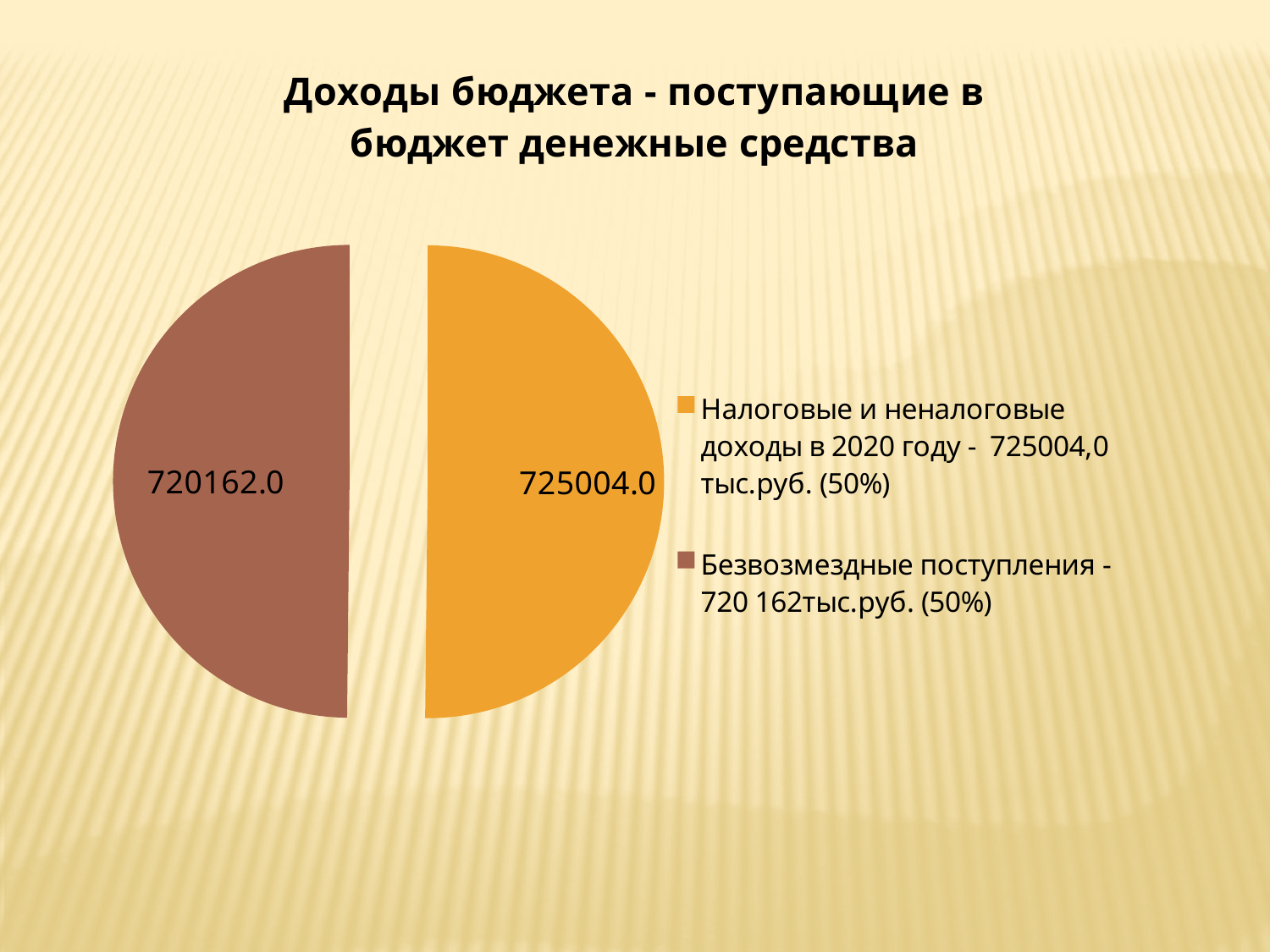
What is the title of the chart on the slide? Доходы бюджета - поступающие в бюджет денежные средства What is the difference between the values of the two slices? 4842.0 What share of the pie does 'Налоговые и неналоговые доходы в 2020 году' represent according to the legend? 50% What is the value shown for the slice 'Налоговые и неналоговые доходы в 2020 году'? 725004.0 What type of chart is shown on the slide? Pie chart What is the value shown for the slice 'Безвозмездные поступления'? 720162.0 How many slices does the pie chart have? 2 Which slice has the larger value, 'Налоговые и неналоговые доходы' or 'Безвозмездные поступления'? Налоговые и неналоговые доходы What share of the pie does 'Безвозмездные поступления' represent according to the legend? 50% What colour is the slice for 'Безвозмездные поступления'? Brown Which category has the smallest value in the pie chart? Безвозмездные поступления